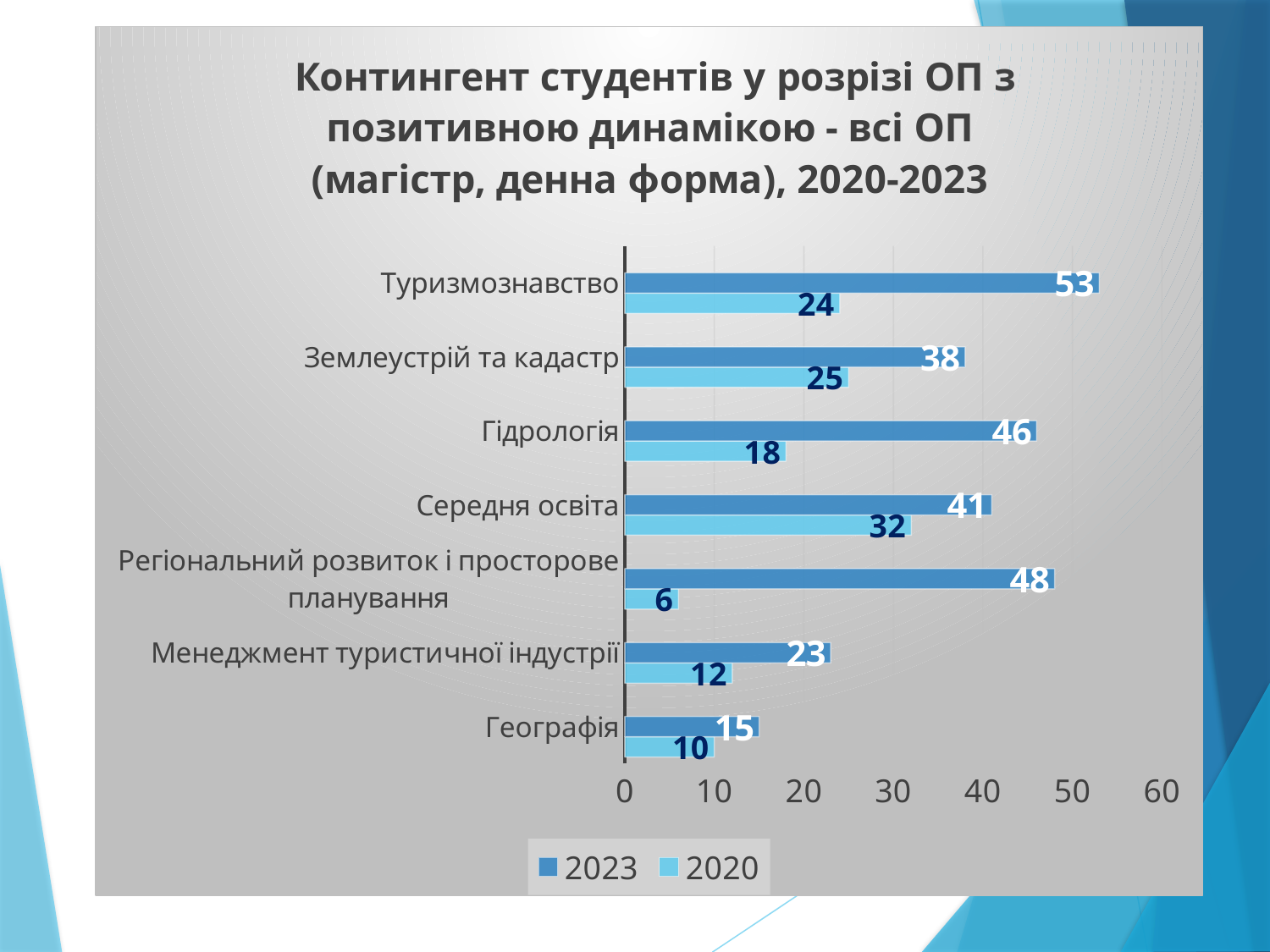
What is the 2020 value for Гідрологія? 18 How many categories are shown on the chart? 7 Which is larger: the 2023 value for Гідрологія or the 2023 value for Середня освіта? Гідрологія How many series does the legend list? 2 What kind of chart is shown on the slide? Bar chart What is the 2023 value for Туризмознавство? 53 What is the 2023 value for Географія? 15 Which series does the lighter blue colour represent in the legend? 2020 What is the 2020 value for Регіональний розвиток і просторове планування? 6 What is the difference between the 2023 and 2020 values for Землеустрій та кадастр? 13 Which category has the lowest 2020 value? Регіональний розвиток і просторове планування Which category has the highest 2023 value? Туризмознавство